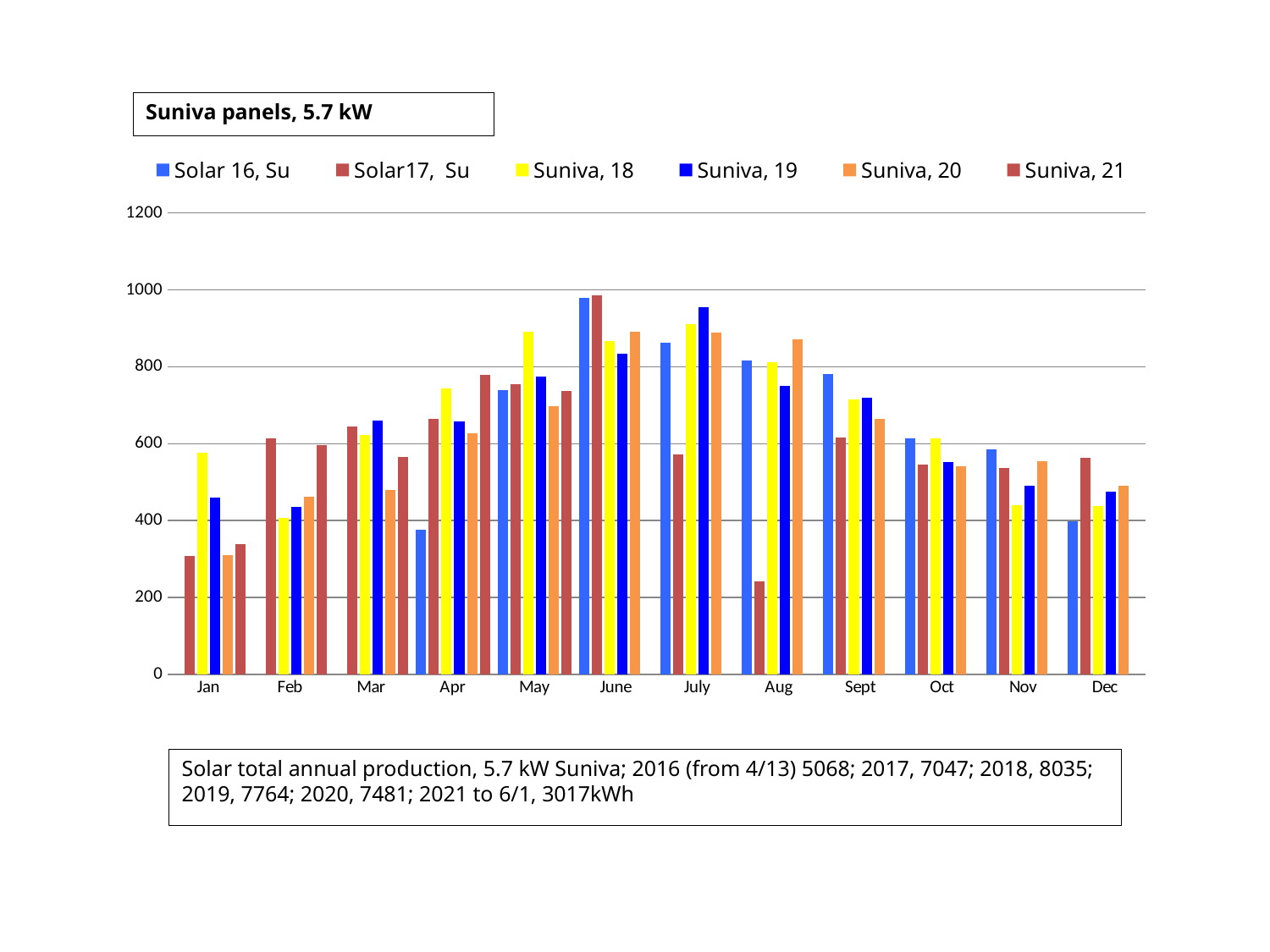
How many months are shown along the x axis? 12 How many series does the legend list? 6 What is the title of the chart? Suniva panels, 5.7 kW Is the value for Solar17, Su in Aug greater or less than 400? less In which month is the Solar17, Su bar highest? June In Aug, which is larger: Solar 16, Su or Solar17, Su? Solar 16, Su Is the value for Suniva, 18 in Jan greater or less than 400? greater Is the value for Solar 16, Su in June greater or less than 800? greater What kind of chart is shown on the slide? bar chart Which series is shown in yellow in the legend? Suniva, 18 Does the Solar17, Su series rise or fall from Jan to June? rise